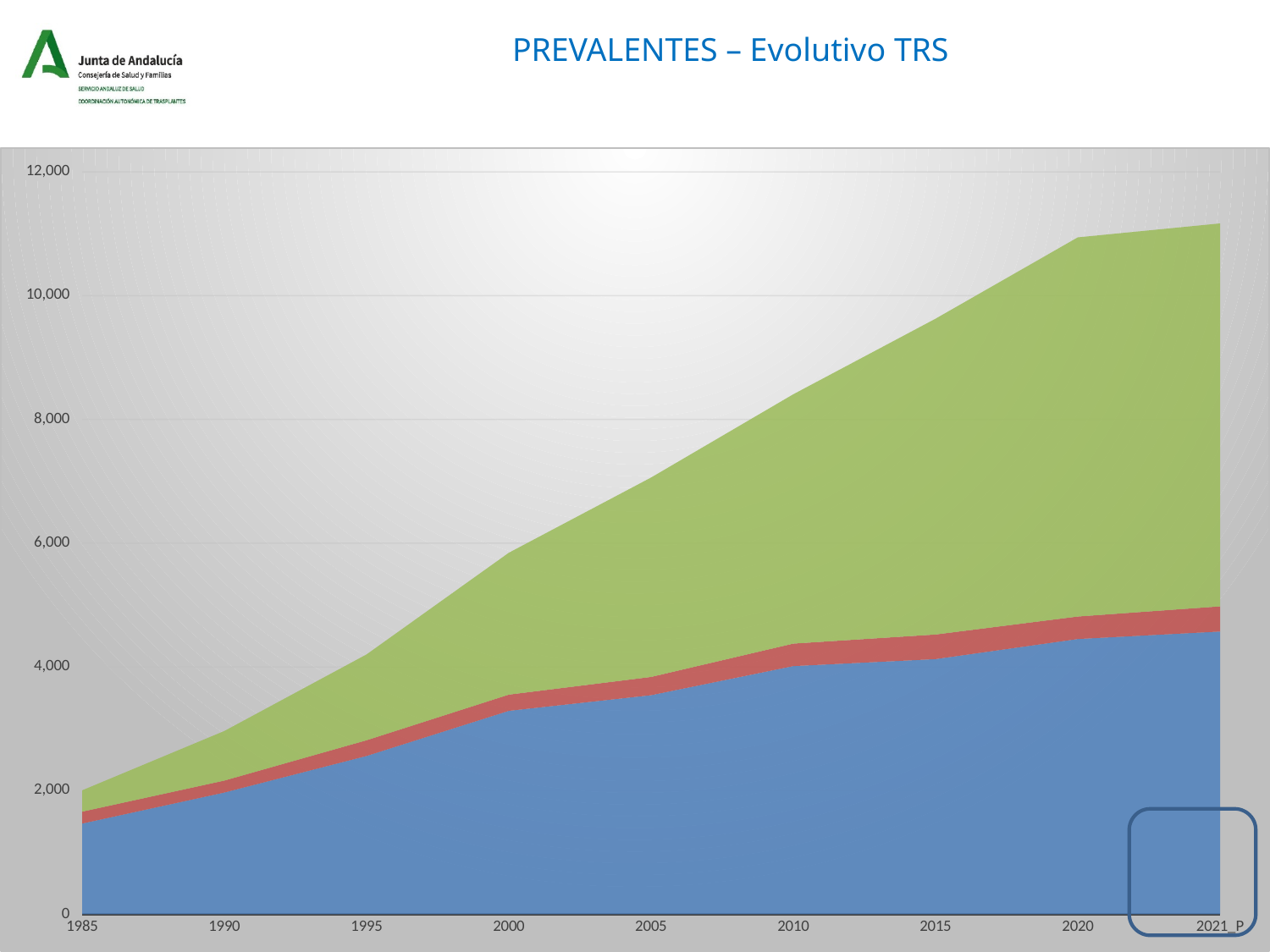
Does the total stacked value rise or fall from 1985 to 2021_P? Rise Is the total stacked value in 2020 greater or less than 10,000? greater What is the title of the chart on the slide? PREVALENTES – Evolutivo TRS Which year label is the last one on the x axis of the chart? 2021_P What kind of chart is shown on the slide? Stacked area chart Is the total stacked value in 2005 greater or less than 6,000? greater Is the total stacked value in 2010 greater or less than 8,000? greater What is the highest value shown on the y axis of the chart? 12,000 How many year labels are shown along the x axis of the chart? 9